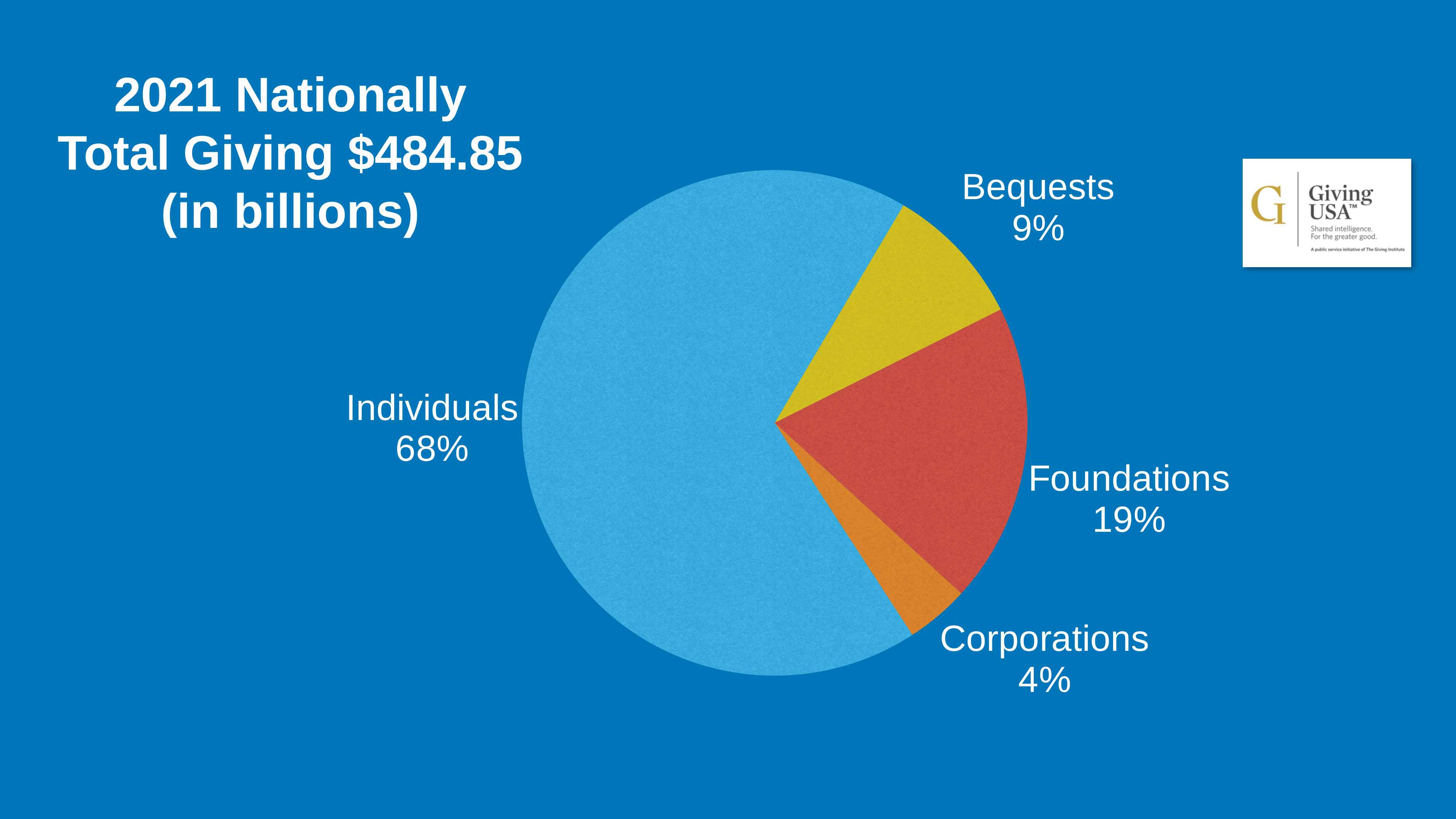
How many slices does the pie chart have? 4 What share of total giving comes from Bequests? 9% Which is larger, the share for Foundations or the share for Bequests? Foundations What is the difference in percentage points between the Bequests share and the Corporations share? 5 percentage points What share of total giving comes from Foundations? 19% What share of total giving comes from Corporations? 4% What is the difference in percentage points between the Individuals share and the Foundations share? 49 percentage points What kind of chart is shown on the slide? Pie chart Which source accounts for the largest share of total giving? Individuals What share of total giving comes from Individuals? 68% Which source accounts for the smallest share of total giving? Corporations What total giving amount is stated in the chart title? $484.85 (in billions)